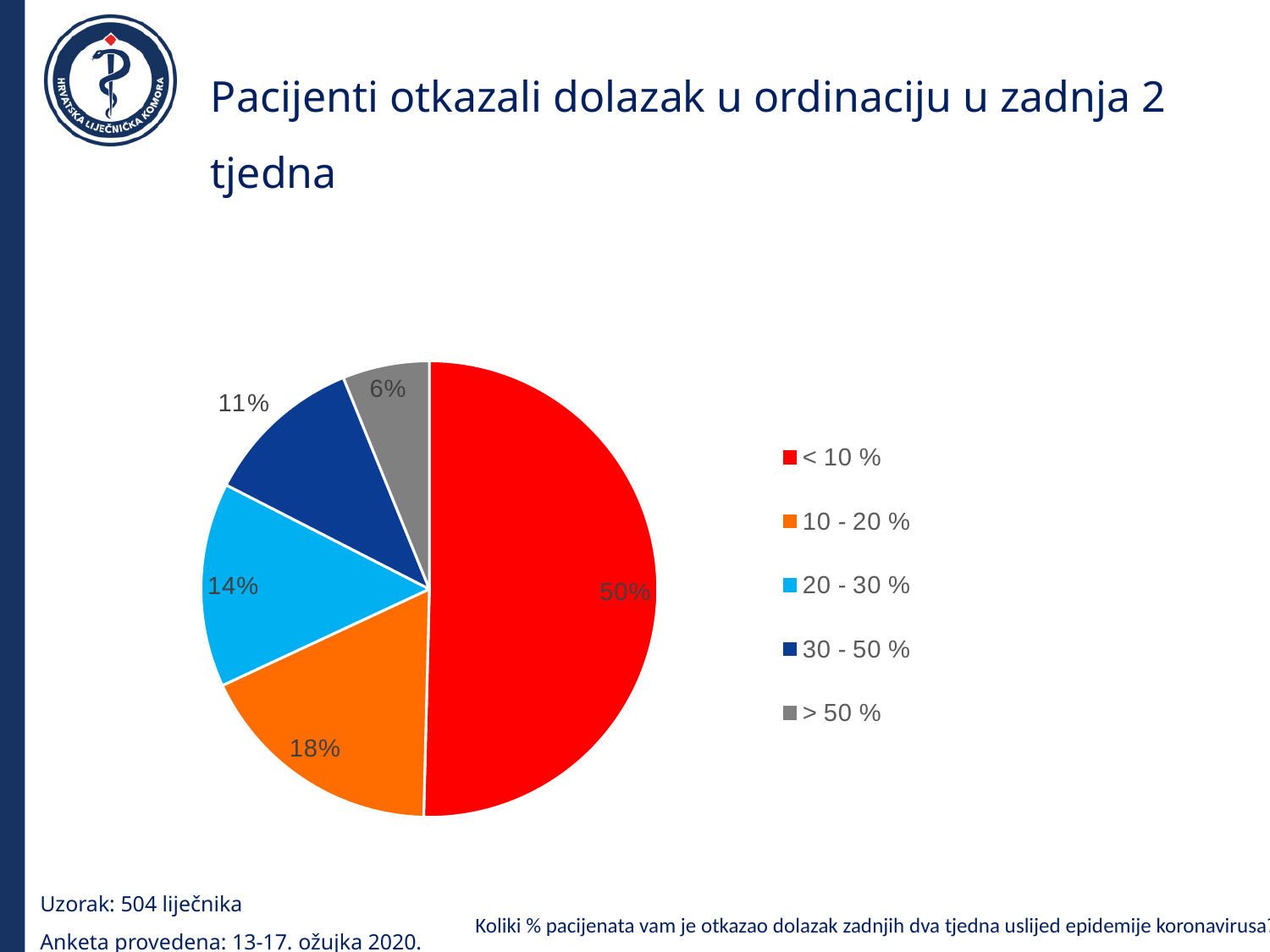
What colour is the "> 50 %" slice? grey Which category has the largest slice of the pie? < 10 % Which category has the smallest slice of the pie? > 50 % What share of the pie does the "< 10 %" slice represent? 50% What is the value for the "10 - 20 %" category? 18% What is the value for the "30 - 50 %" category? 11% What is the value for the "20 - 30 %" category? 14% What kind of chart is shown on the slide? pie chart What is the value for the "> 50 %" category? 6% What is the difference between the "< 10 %" slice and the "10 - 20 %" slice? 32% Which is larger, the "20 - 30 %" slice or the "30 - 50 %" slice? 20 - 30 % How many categories does the legend list? 5